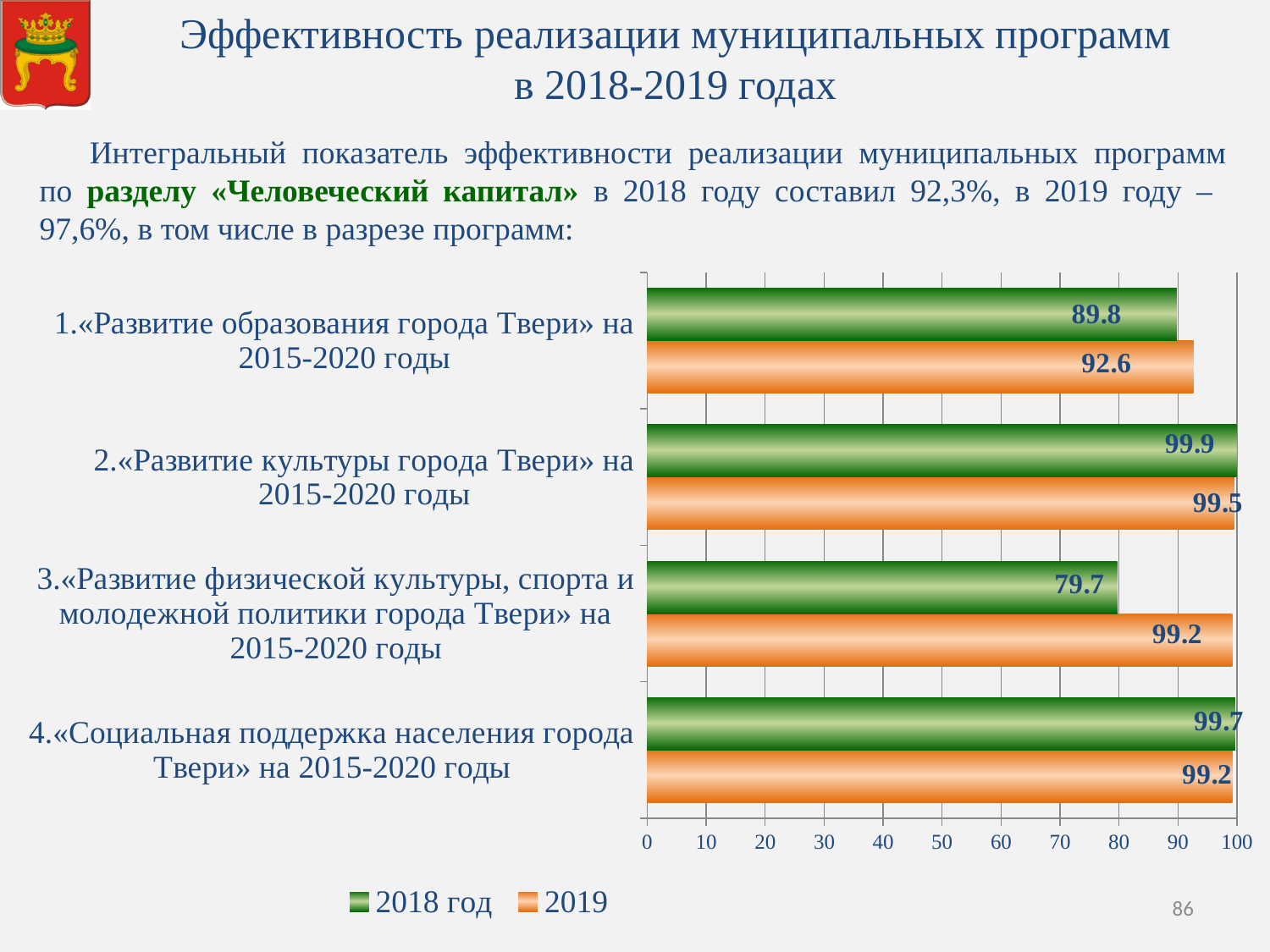
For «Развитие образования города Твери» на 2015-2020 годы, which is larger: the 2018 год value or the 2019 value? 2019 Which program has the lowest 2018 год value? «Развитие физической культуры, спорта и молодежной политики города Твери» на 2015-2020 годы How many programs (categories) are shown in the chart? 4 Which program has the highest 2018 год value? «Развитие культуры города Твери» на 2015-2020 годы How many series does the chart legend list? 2 What is the 2019 value for «Развитие культуры города Твери» на 2015-2020 годы? 99.5 What is the 2019 value for «Развитие физической культуры, спорта и молодежной политики города Твери» на 2015-2020 годы? 99.2 What type of chart is shown on the slide? bar chart What is the difference between the 2019 and 2018 год values for «Развитие физической культуры, спорта и молодежной политики города Твери» на 2015-2020 годы? 19.5 What colour are the bars for the 2019 series? orange What is the 2018 год value for «Развитие образования города Твери» на 2015-2020 годы? 89.8 Is the 2018 год value for «Развитие физической культуры, спорта и молодежной политики города Твери» на 2015-2020 годы greater or less than 90? less